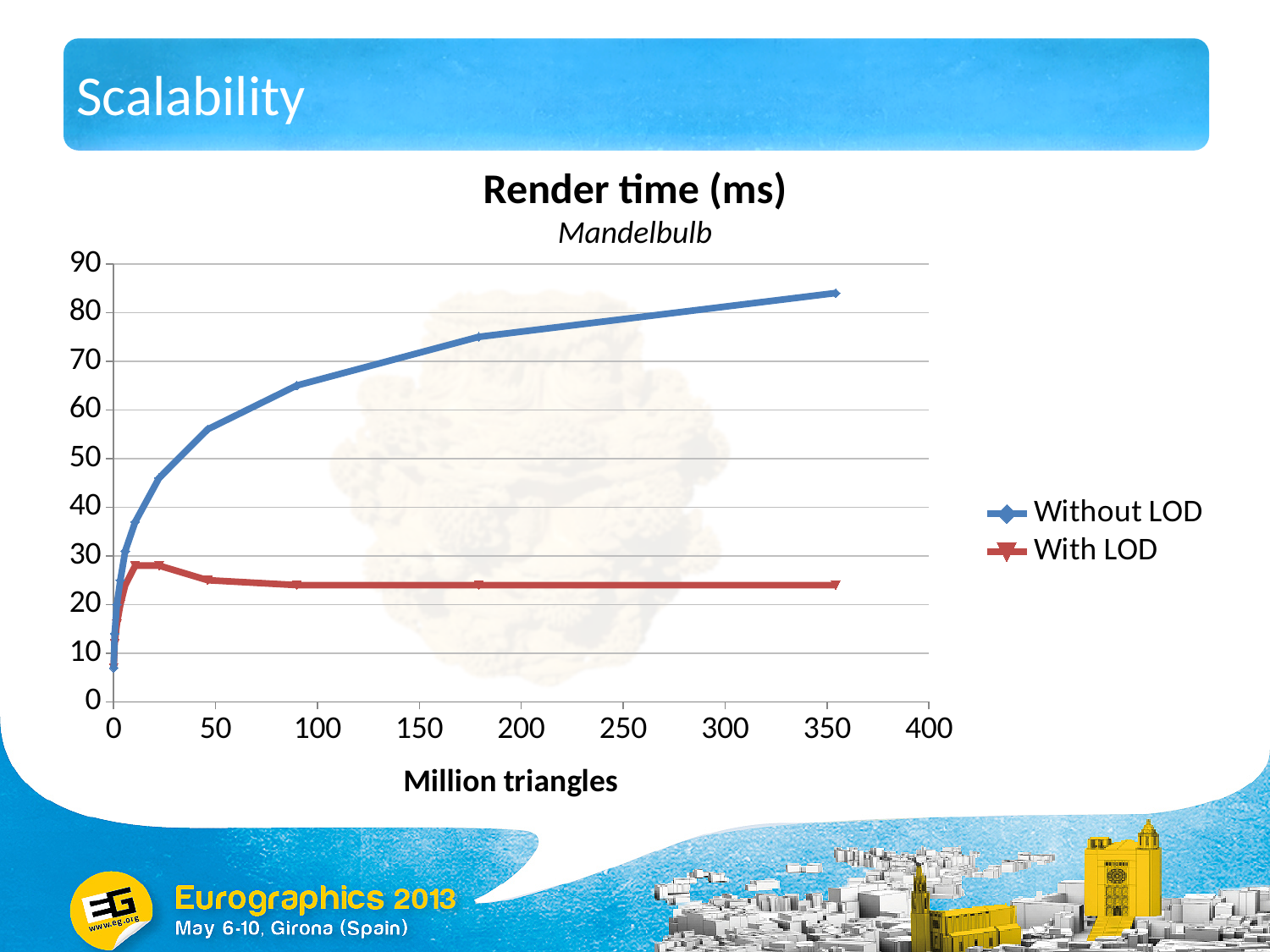
How many series does the legend list? 2 What kind of chart is shown on the slide? line chart What is the label of the x axis? Million triangles What is the title of the chart? Render time (ms) Does the Without LOD series rise or fall as the number of million triangles increases? rises Is the value for Without LOD at about 350 million triangles greater or less than 80? greater Is the value for Without LOD at 100 million triangles greater or less than 60? greater At 350 million triangles, which series has the higher render time, Without LOD or With LOD? Without LOD Is the value for With LOD at about 350 million triangles greater or less than 30? less Which series reaches the highest render time on the chart? Without LOD